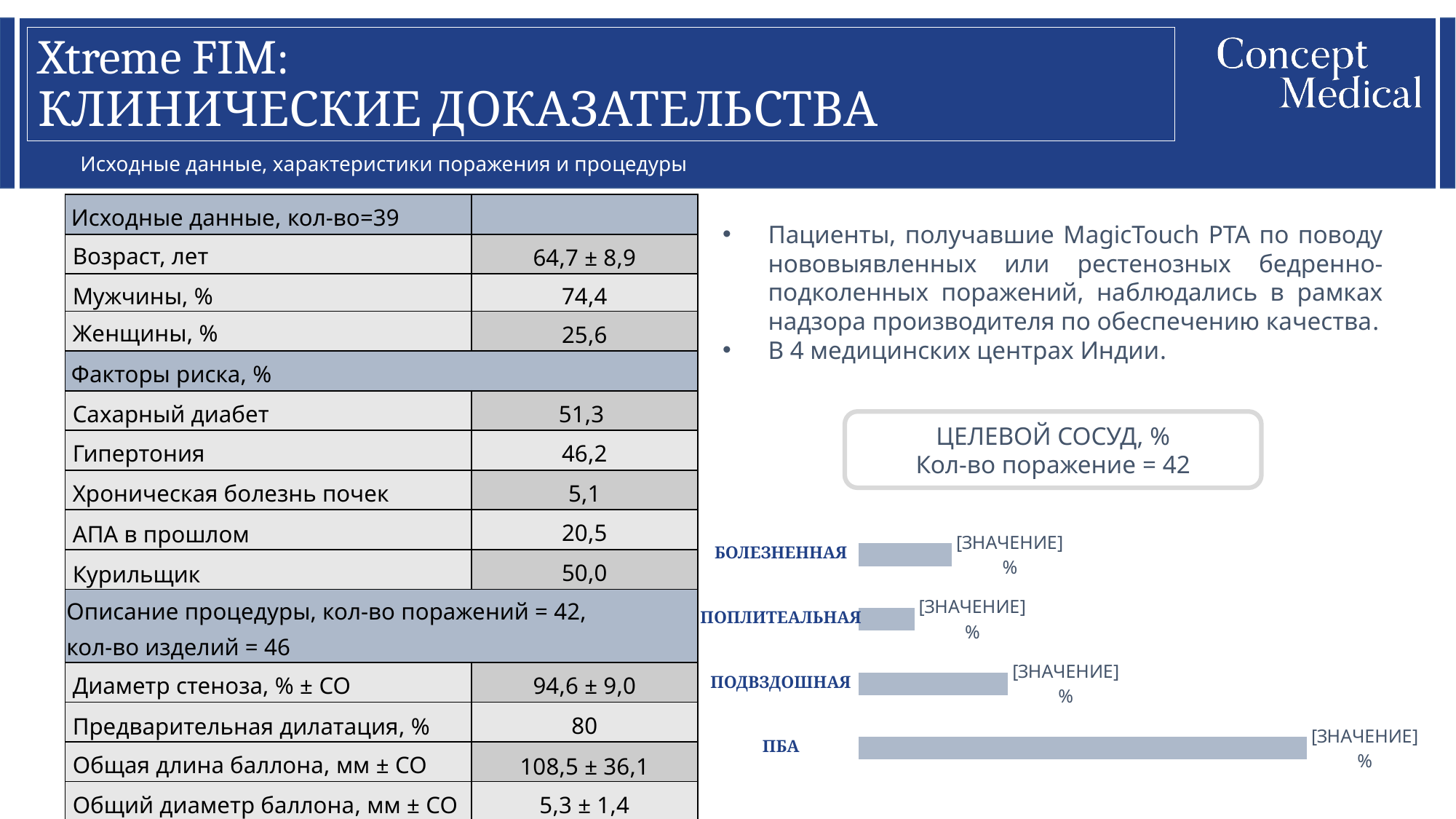
In the "ЦЕЛЕВОЙ СОСУД, %" chart, which category has the shortest bar? ПОПЛИТЕАЛЬНАЯ What number of lesions is stated in the heading box above the bar chart? 42 In the "ЦЕЛЕВОЙ СОСУД, %" chart, which category has the longest bar? ПБА How many categories does the "ЦЕЛЕВОЙ СОСУД, %" bar chart show? 4 Which category is listed at the bottom of the "ЦЕЛЕВОЙ СОСУД, %" bar chart? ПБА In the "ЦЕЛЕВОЙ СОСУД, %" chart, which bar is longer: ПОДВЗДОШНАЯ or БОЛЕЗНЕННАЯ? ПОДВЗДОШНАЯ In the "ЦЕЛЕВОЙ СОСУД, %" chart, which bar is longer: БОЛЕЗНЕННАЯ or ПОПЛИТЕАЛЬНАЯ? БОЛЕЗНЕННАЯ What kind of chart is shown under the heading "ЦЕЛЕВОЙ СОСУД, %"? bar chart In the "ЦЕЛЕВОЙ СОСУД, %" chart, which bar is longer: ПБА or ПОДВЗДОШНАЯ? ПБА